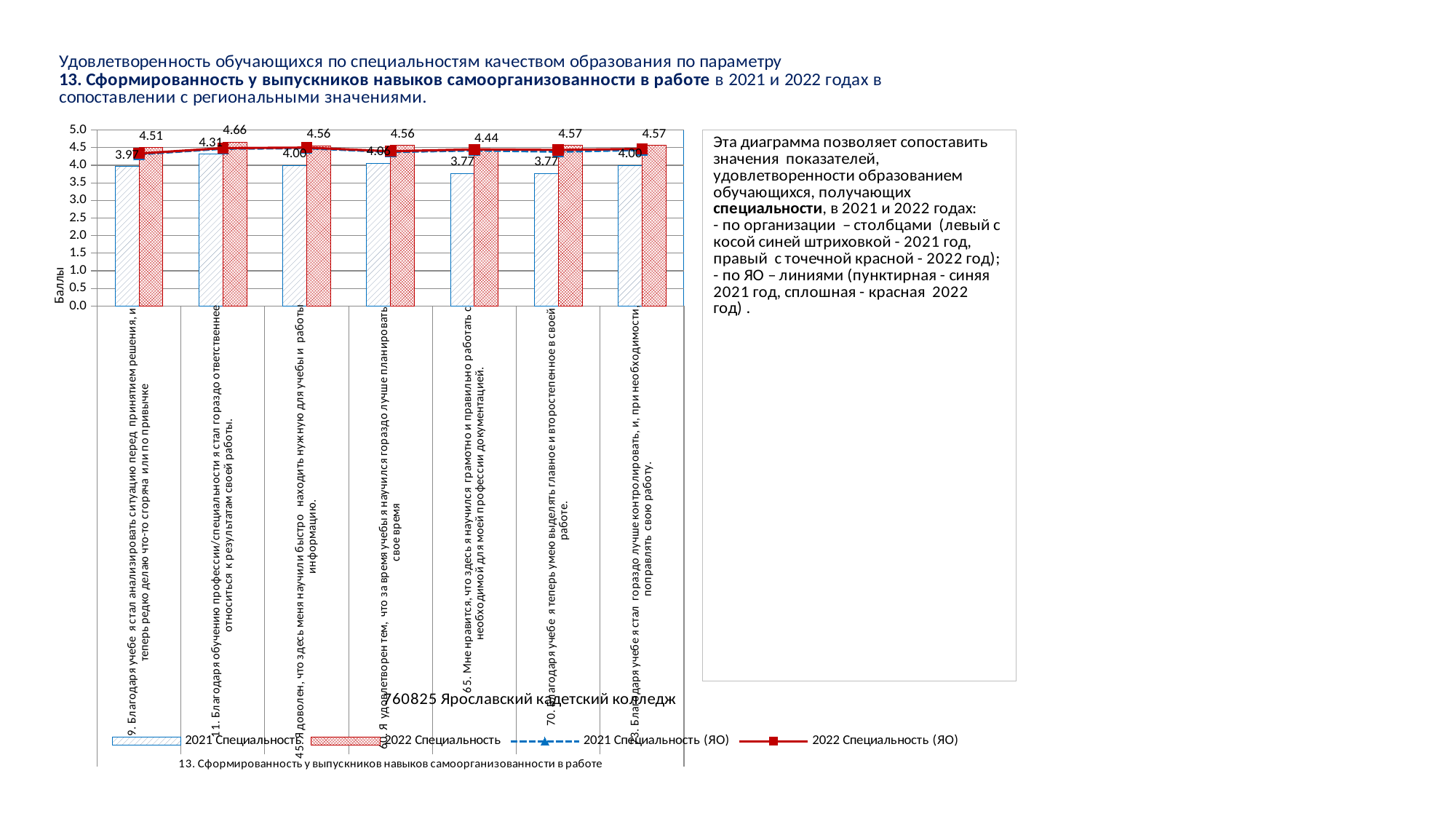
How many series does the legend list? 4 Which item has the lowest 2022 Специальность value? 65. Мне нравится, что здесь я научился грамотно и правильно работать с необходимой для моей профессии документацией What is the value of the 2022 Специальность bar for item 11 (Благодаря обучению профессии/специальности я стал гораздо ответственнее относиться к результатам своей работы)? 4.66 What is the value of the 2021 Специальность bar for item 65 (Мне нравится, что здесь я научился грамотно и правильно работать с необходимой для моей профессии документацией)? 3.77 Is the 2021 Специальность value for item 70 greater or less than 4.0? less What is the value of the 2022 Специальность bar for item 65? 4.44 What is the difference between the 2022 and 2021 Специальность values for item 11? 0.35 Which is larger for item 70: the 2021 Специальность bar or the 2022 Специальность bar? 2022 Специальность What is the difference between the 2022 and 2021 Специальность values for item 65? 0.67 What is the value of the 2021 Специальность bar for item 73 (Благодаря учебе я стал гораздо лучше контролировать, и, при необходимости поправлять свою работу)? 4.00 How many items (categories) are shown on the x axis? 7 Which item has the highest 2022 Специальность value? 11. Благодаря обучению профессии/специальности я стал гораздо ответственнее относиться к результатам своей работы